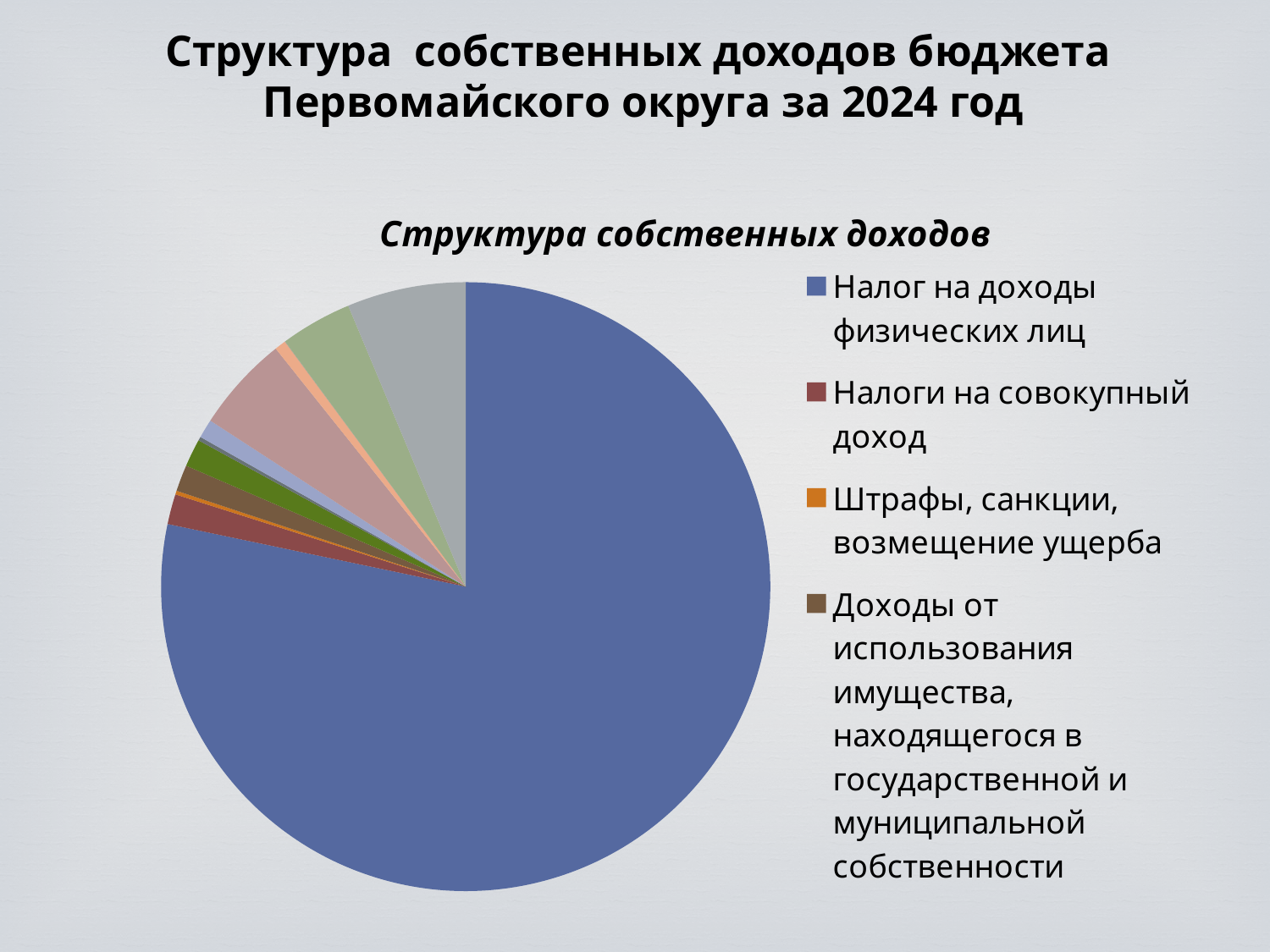
What colour is the slice for Налог на доходы физических лиц? blue What kind of chart is shown on the slide? pie chart How many entries are listed in the chart's legend? 4 Which is larger: the slice for Налоги на совокупный доход or the slice for Штрафы, санкции, возмещение ущерба? Налоги на совокупный доход What is the title of the chart? Структура собственных доходов Which category has the largest slice of the pie? Налог на доходы физических лиц Which is larger: the slice for Налог на доходы физических лиц or the slice for Налоги на совокупный доход? Налог на доходы физических лиц